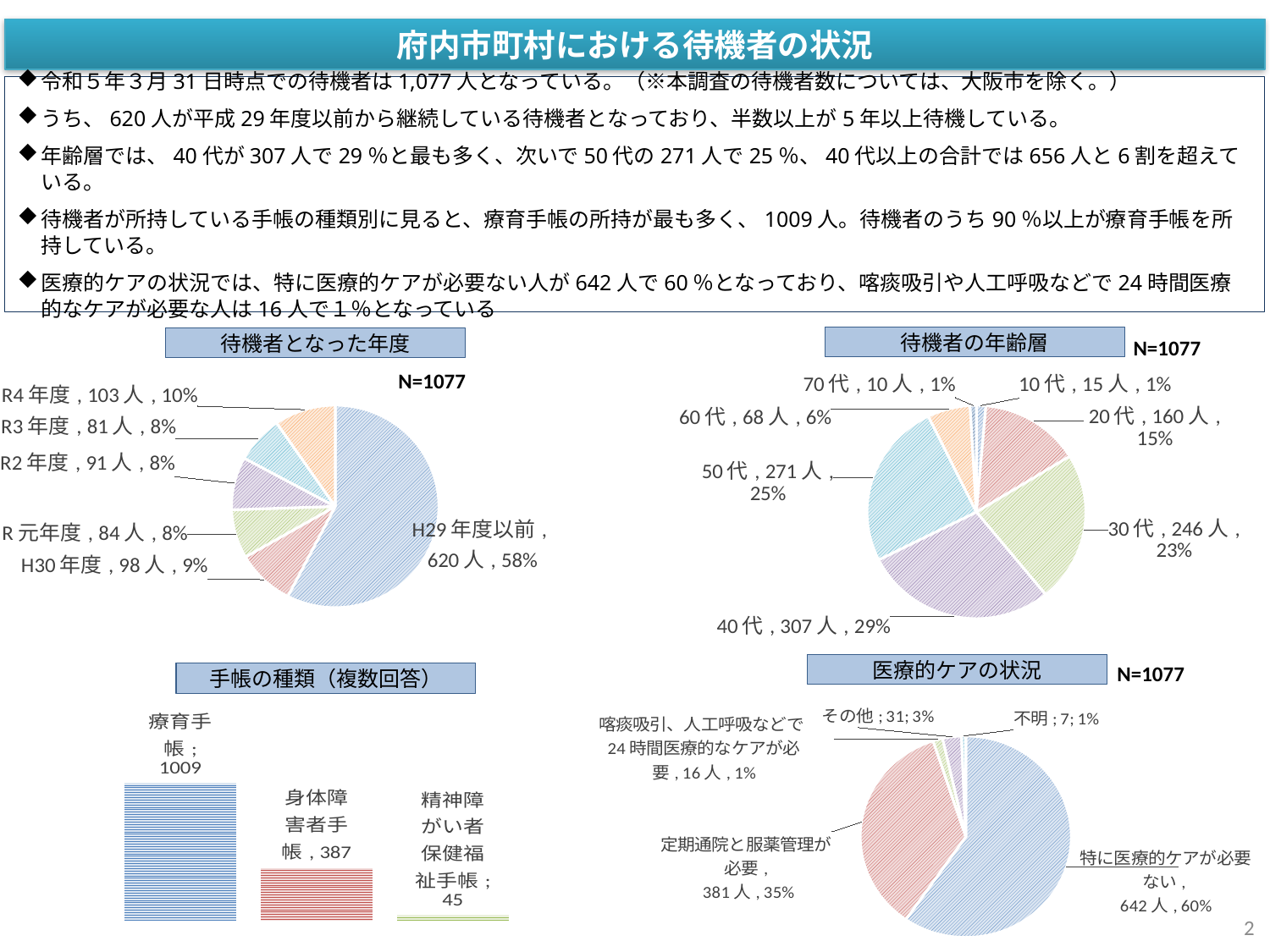
In the 待機者の年齢層 chart, what is the difference in people between 40代 and 50代? 36人 In the 手帳の種類（複数回答） chart, what is the difference between 療育手帳 and 精神障がい者保健福祉手帳? 964 In the 待機者の年齢層 chart, which age group has the largest number of people? 40代 What kind of chart is the 手帳の種類（複数回答） chart? bar chart In the 待機者の年齢層 chart, which has more people, 20代 or 30代? 30代 In the 待機者となった年度 chart, how many people are in the H29年度以前 category? 620人 In the 医療的ケアの状況 chart, how many people are in the 定期通院と服薬管理が必要 category? 381人 What N value is shown next to the 医療的ケアの状況 chart? N=1077 In the 待機者の年齢層 chart, which age group has the smallest number of people? 70代 In the 手帳の種類（複数回答） chart, what is the value for 身体障害者手帳? 387 In the 待機者となった年度 chart, how many categories are shown? 6 In the 待機者となった年度 chart, what share of the pie does R4年度 represent? 10%